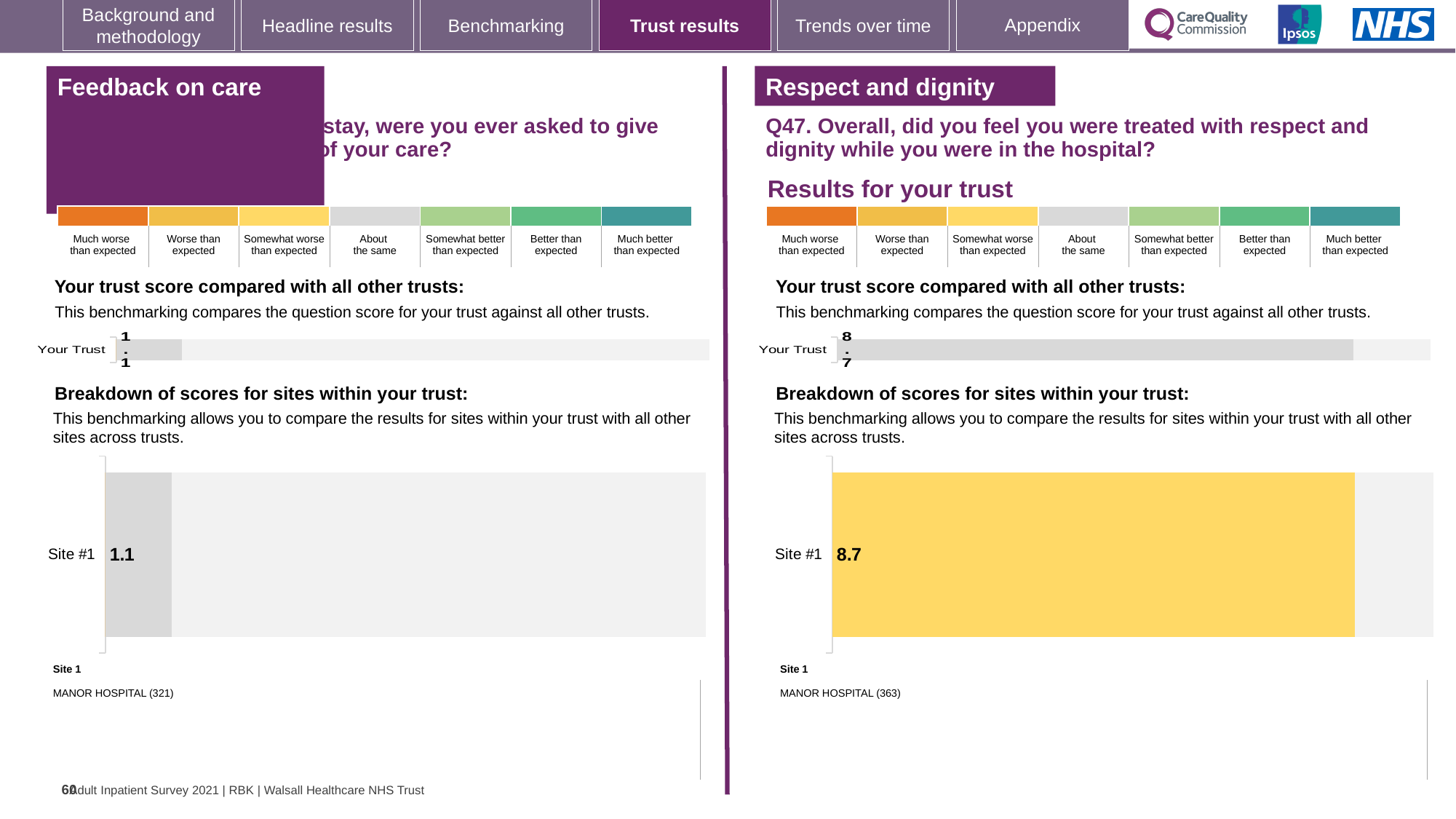
What colour is the Site #1 bar in the right-hand 'Respect and dignity' breakdown chart? Yellow On the left-hand 'Feedback on care' section, what is the 'Your Trust' score in the chart comparing the trust with all other trusts? 1.1 Which site name is listed as Site 1 beneath the right-hand 'Respect and dignity' breakdown chart? MANOR HOSPITAL (363) On the left-hand 'Feedback on care' section, what is the score shown for Site #1 in the breakdown of scores for sites within your trust? 1.1 What type of chart is used to show the Site #1 score in the right-hand 'Respect and dignity' section? Bar chart How many sites are shown in the breakdown of scores chart in the left-hand 'Feedback on care' section? 1 What is the difference between the Site #1 score in the right-hand 'Respect and dignity' chart and the Site #1 score in the left-hand 'Feedback on care' chart? 7.6 How many sites are shown in the breakdown of scores chart in the right-hand 'Respect and dignity' section? 1 On the right-hand 'Respect and dignity' section, what is the score shown for Site #1 in the breakdown of scores for sites within your trust? 8.7 Which Site #1 score is larger: the one in the left-hand 'Feedback on care' chart or the one in the right-hand 'Respect and dignity' chart? Respect and dignity (8.7) On the right-hand 'Respect and dignity' section, what is the 'Your Trust' score in the chart comparing the trust with all other trusts? 8.7